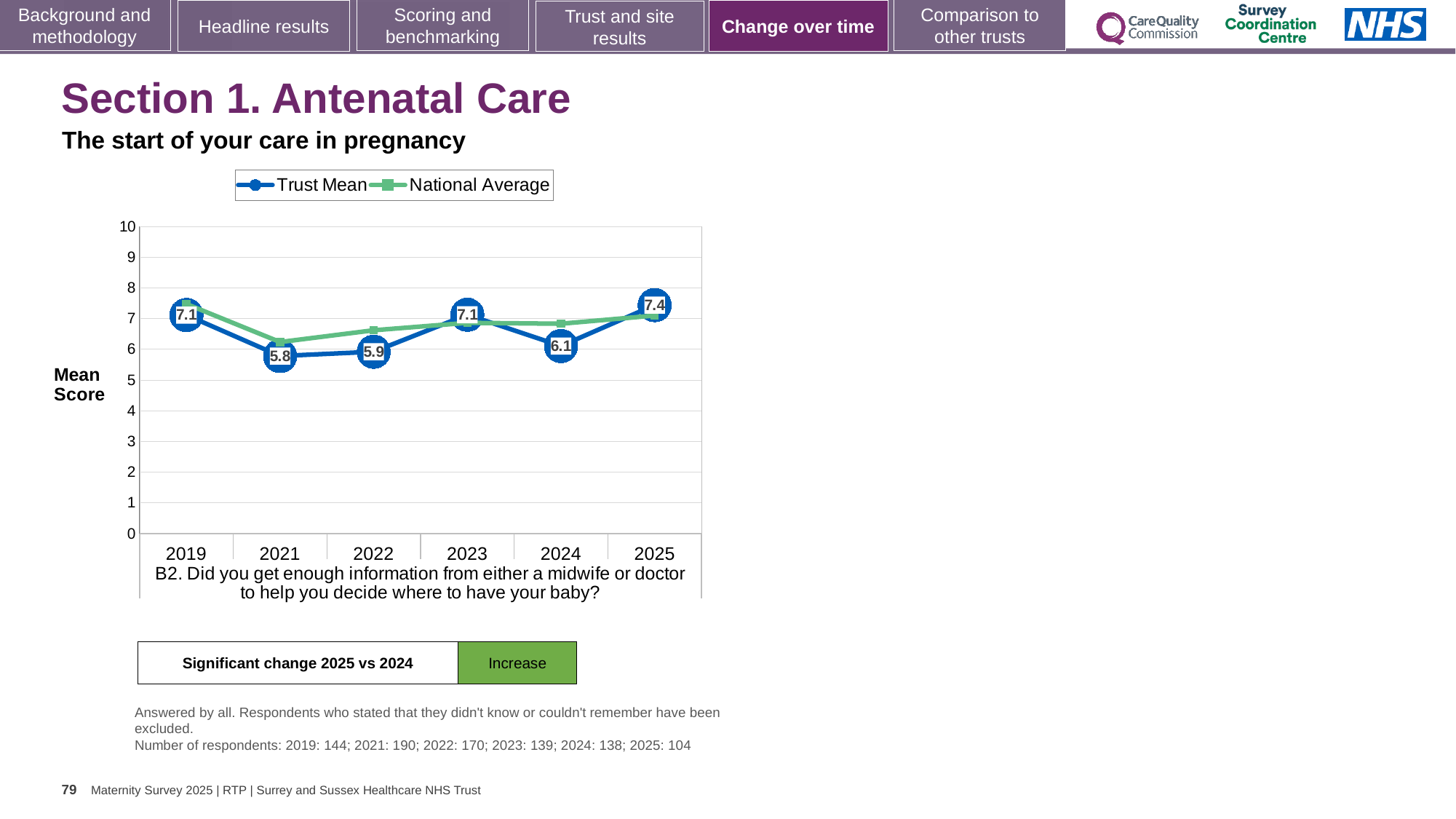
Which year has the larger Trust Mean, 2022 or 2023? 2023 Does the Trust Mean rise or fall from 2024 to 2025? Rise What is the difference between the Trust Mean in 2025 and in 2024? 1.3 What is the Trust Mean value for 2021? 5.8 What is the Trust Mean value for 2025? 7.4 What kind of chart is shown on the slide? Line chart How many years are plotted on the x axis? 6 Is the National Average value for 2019 greater or less than 7? greater What is the Trust Mean value for 2024? 6.1 In which year is the Trust Mean lowest? 2021 How many series does the legend list? 2 In which year is the Trust Mean highest? 2025